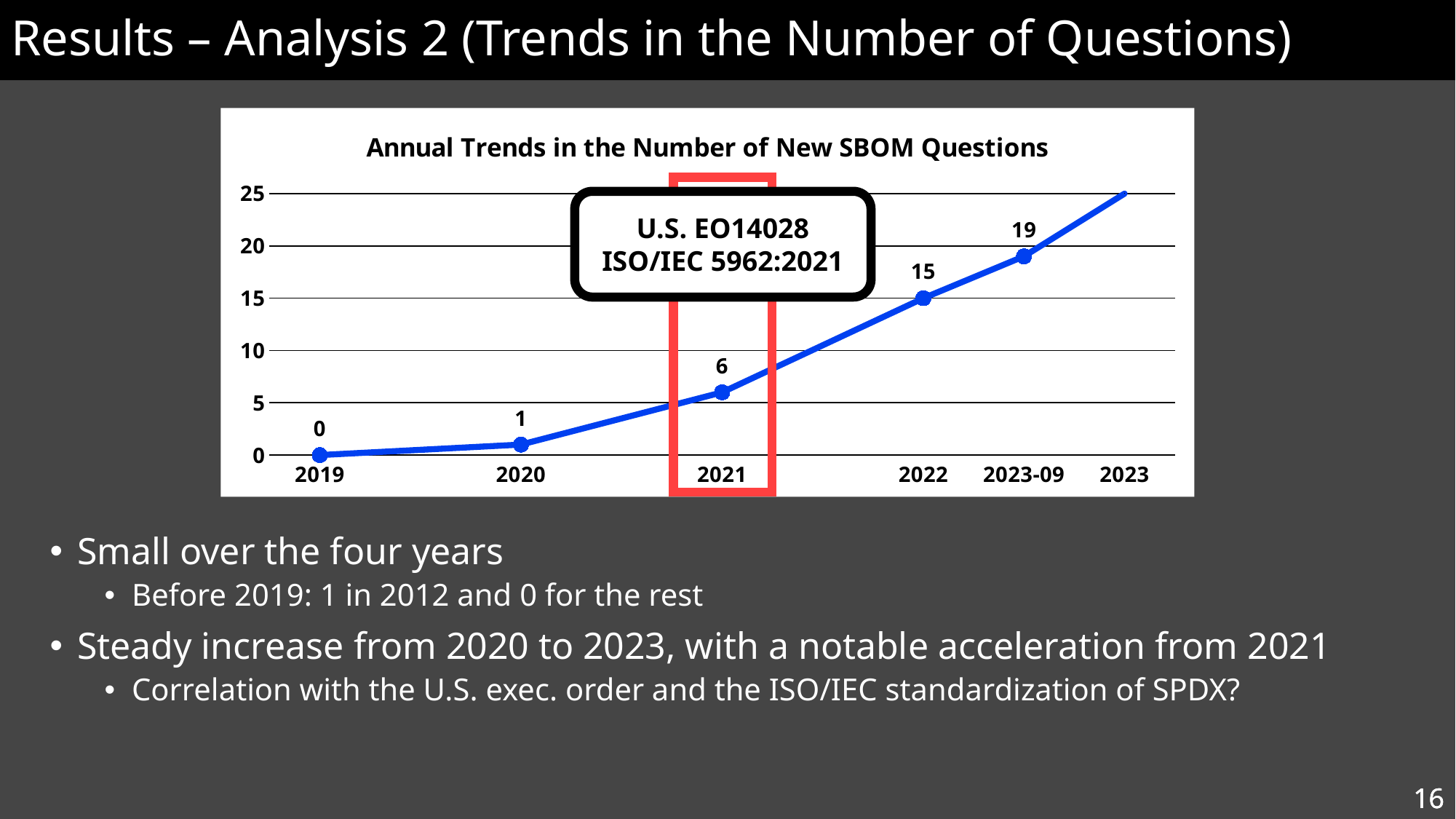
What is the value plotted for 2019? 0 Which has a larger value, 2020 or 2021? 2021 Which year has the lowest number of new SBOM questions? 2019 Is the value for 2023 greater or less than 20? greater What is the value plotted for 2020? 1 Do the values rise or fall from 2019 to 2023? Rise What is the number of new SBOM questions for 2021? 6 What is the number of new SBOM questions for 2022? 15 What value is shown for 2023-09? 19 What is the difference between the values for 2023-09 and 2022? 4 What kind of chart is shown on the slide? Line chart By how much did the number of new SBOM questions increase from 2021 to 2022? 9